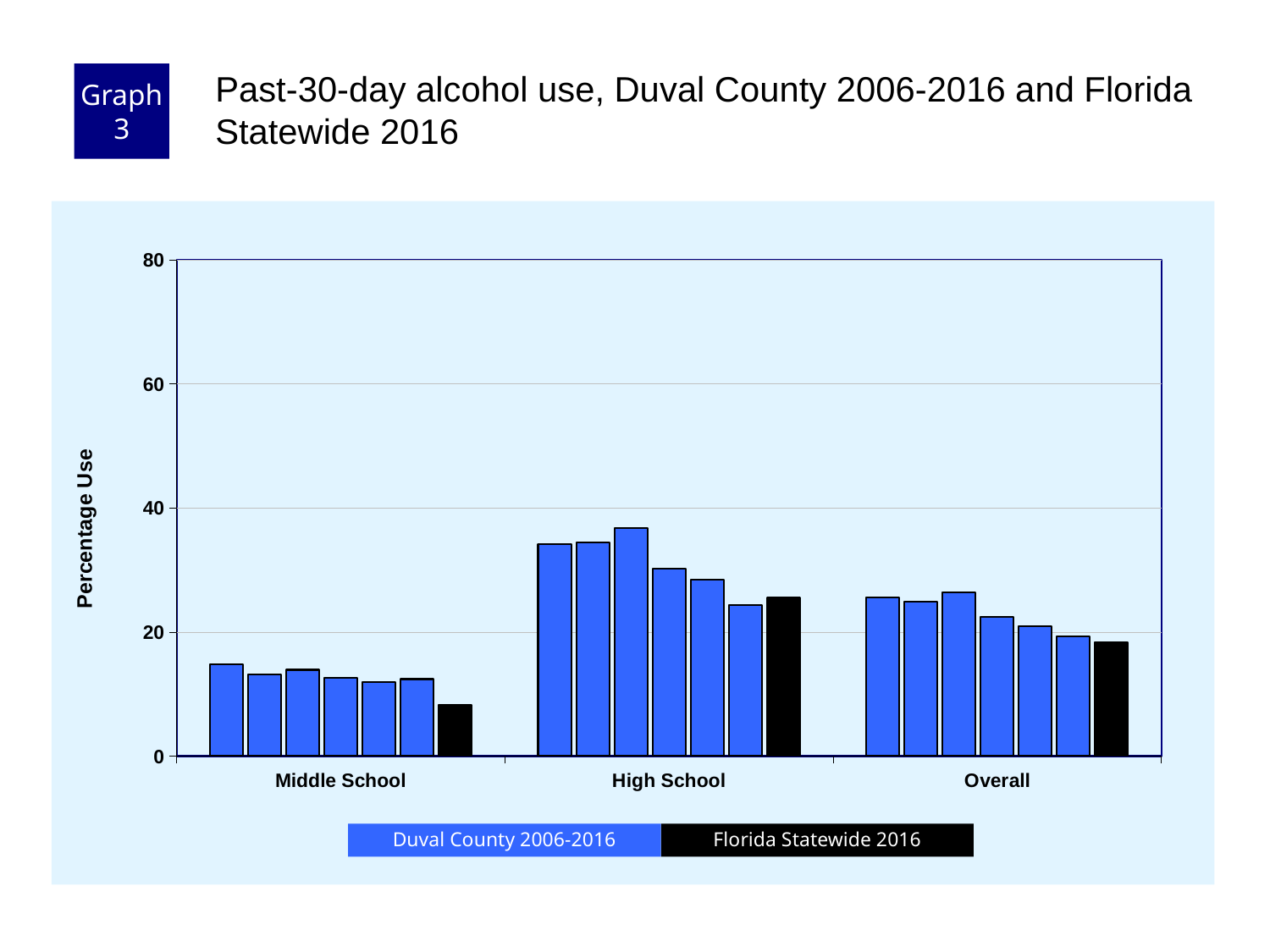
Is the tallest Duval County 2006-2016 bar for High School greater or less than 40? less Is the Florida Statewide 2016 value for Overall greater or less than 20? less What is the label on the y axis? Percentage Use Which category has the highest bars overall? High School Which category has the lowest bars overall? Middle School Is the Florida Statewide 2016 value for High School greater or less than 20? greater How many categories are shown on the x axis? 3 What kind of chart is shown on the slide? bar chart Which colour represents Florida Statewide 2016 in the legend? black How many series does the legend list? 2 Which is larger, the Florida Statewide 2016 value for High School or for Middle School? High School